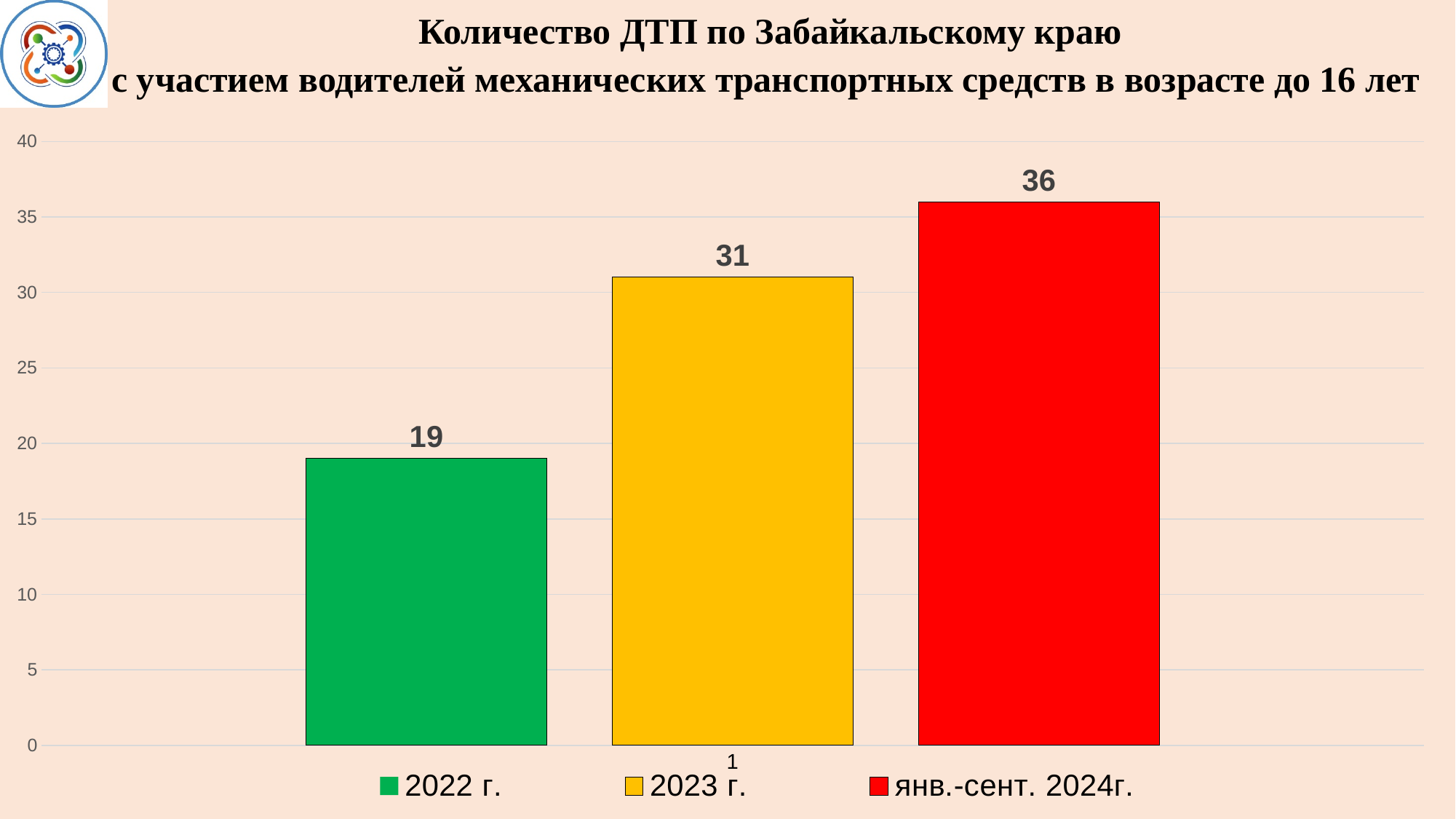
How many series does the legend list? 3 What is the difference between the values for янв.-сент. 2024г. and 2023 г.? 5 What is the value for 2023 г.? 31 What kind of chart is shown on the slide? bar chart Is the value for 2022 г. greater or less than 20? less What is the value for 2022 г.? 19 Which series has the lowest value? 2022 г. Which series has the highest value? янв.-сент. 2024г. What is the value for янв.-сент. 2024г.? 36 What is the difference between the values for 2023 г. and 2022 г.? 12 Which is larger, the value for 2022 г. or the value for 2023 г.? 2023 г. What colour is the bar for янв.-сент. 2024г.? red